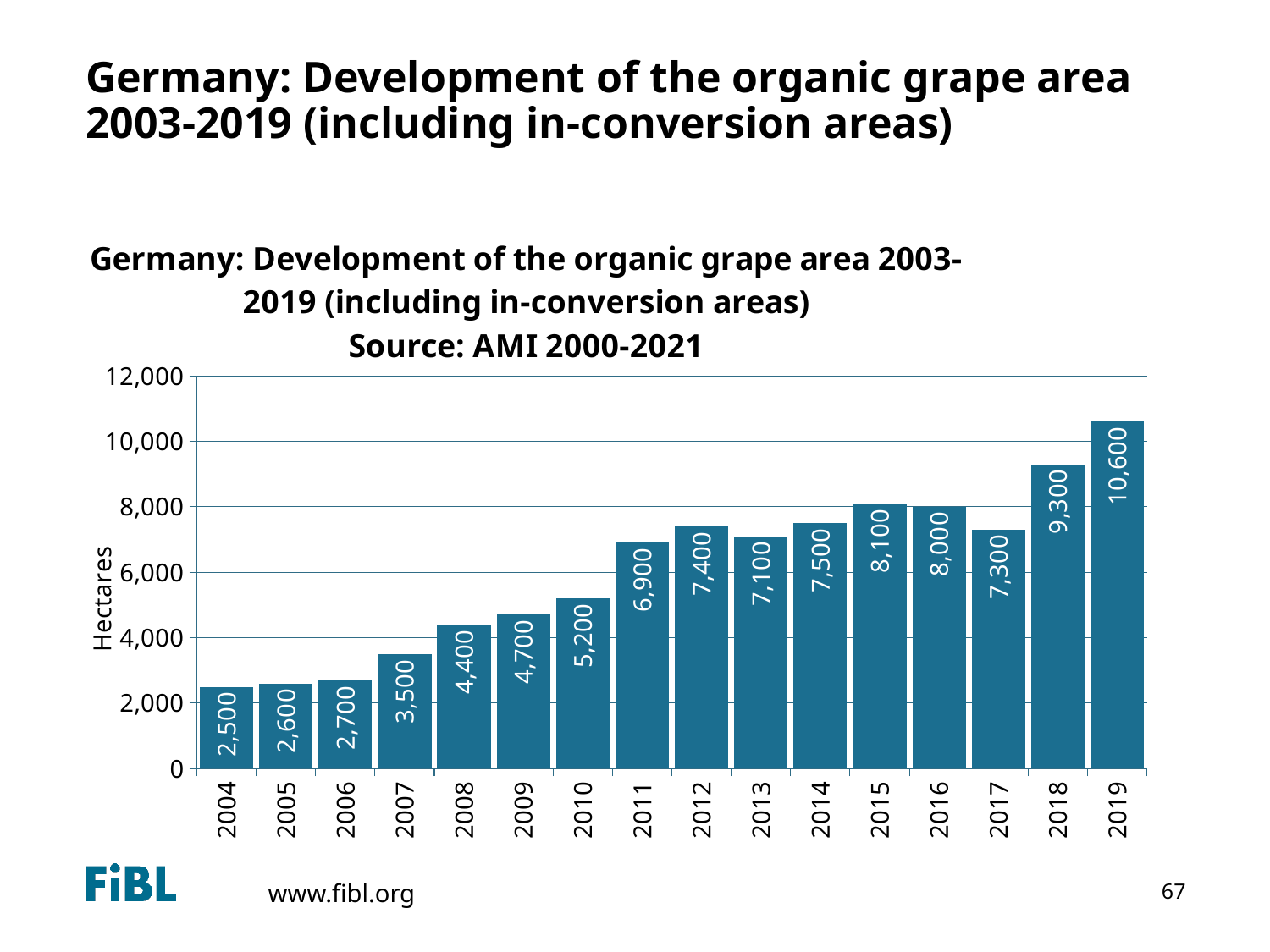
Is the value for 2018 greater or less than 8,000? greater What is the difference between the values for 2019 and 2018? 1,300 How many years are shown on the x axis? 16 Which year has a larger value, 2015 or 2017? 2015 Which year has the lowest organic grape area? 2004 What is the value shown for 2004? 2,500 What is the label of the y axis? Hectares What kind of chart is shown on the slide? Bar chart What is the value shown for 2011? 6,900 What is the organic grape area in Germany in 2019? 10,600 What is the difference between the values for 2010 and 2009? 500 Which year has the highest organic grape area? 2019